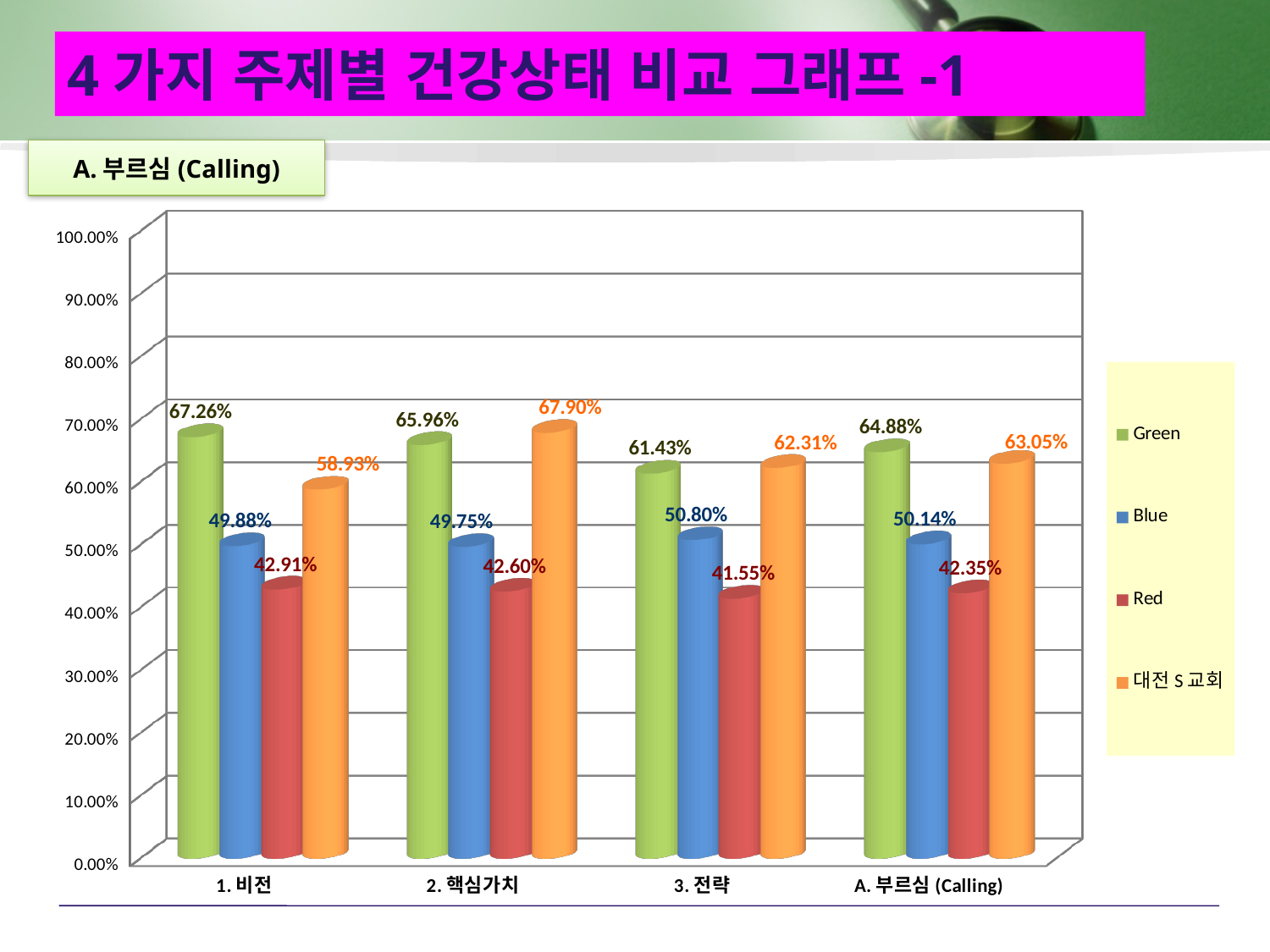
What is the last entry in the chart legend? 대전 S 교회 What kind of chart is shown on the slide? Bar chart What is the value of the Blue series for A. 부르심 (Calling)? 50.14% For 2. 핵심가치, which is larger: the Green value or the 대전 S 교회 value? 대전 S 교회 What is the value of the 대전 S 교회 series for 2. 핵심가치? 67.90% How many series does the legend list? 4 How many categories are shown on the x axis? 4 Which category has the lowest value for the 대전 S 교회 series? 1. 비전 Which category has the highest value for the Green series? 1. 비전 What is the value of the Green series for 1. 비전? 67.26% What is the difference between the Green value and the Red value for 1. 비전? 24.35% What is the value of the Red series for 3. 전략? 41.55%